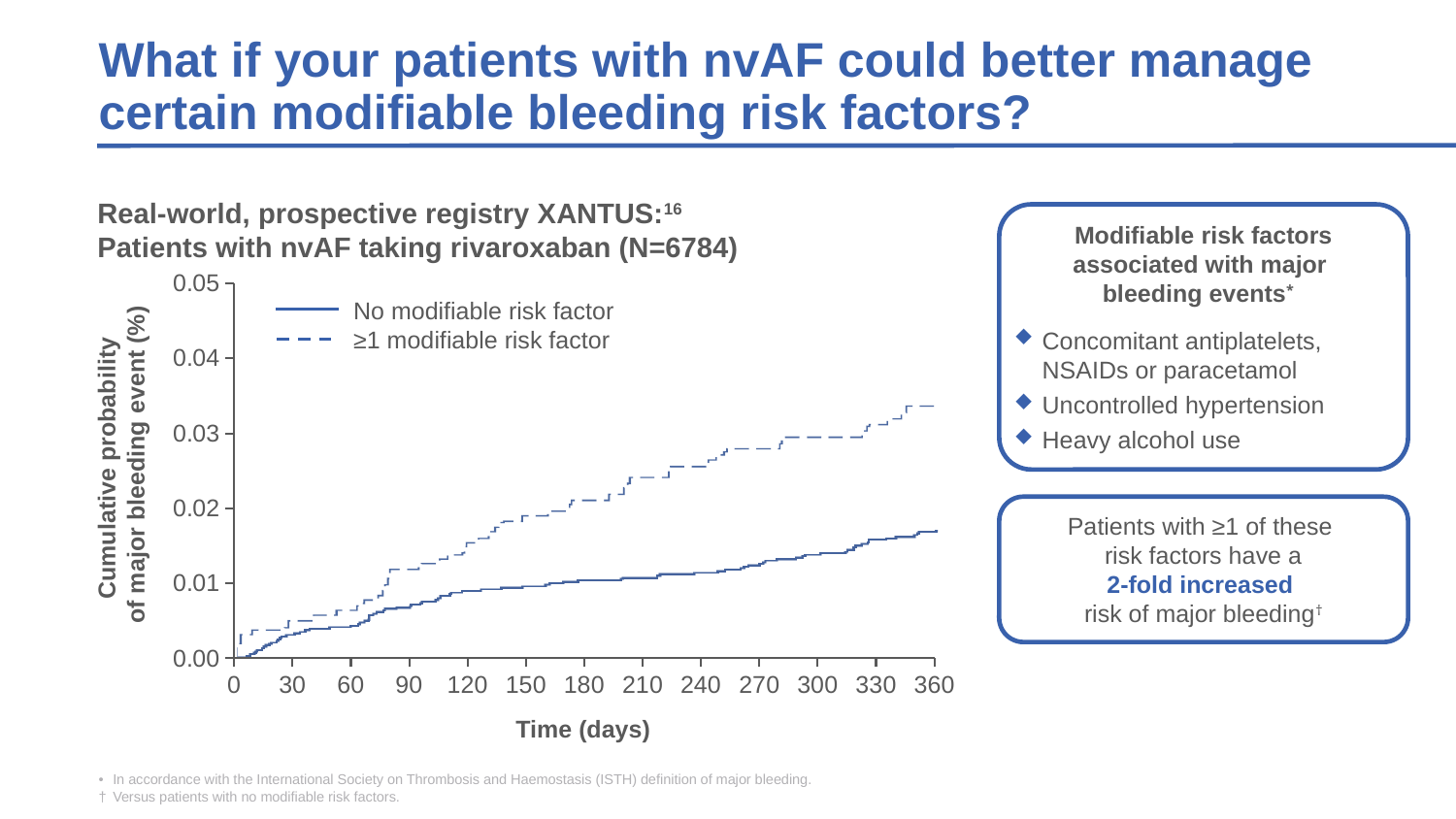
How many series does the chart's legend list? 2 Do the values for the No modifiable risk factor series rise or fall as time increases along the x axis? rise Is the value for the No modifiable risk factor series at 360 days greater or less than 0.02? less Do the values for the ≥1 modifiable risk factor series rise or fall as time increases along the x axis? rise What is the label of the x axis? Time (days) What kind of chart is shown on the slide? line chart Is the value for the ≥1 modifiable risk factor series at 360 days greater or less than 0.03? greater What is the highest tick value shown on the x axis? 360 Is the value for the No modifiable risk factor series at 90 days greater or less than 0.01? less Which series is plotted with a dashed line? ≥1 modifiable risk factor At 360 days, which series has the higher cumulative probability of major bleeding event: No modifiable risk factor or ≥1 modifiable risk factor? ≥1 modifiable risk factor